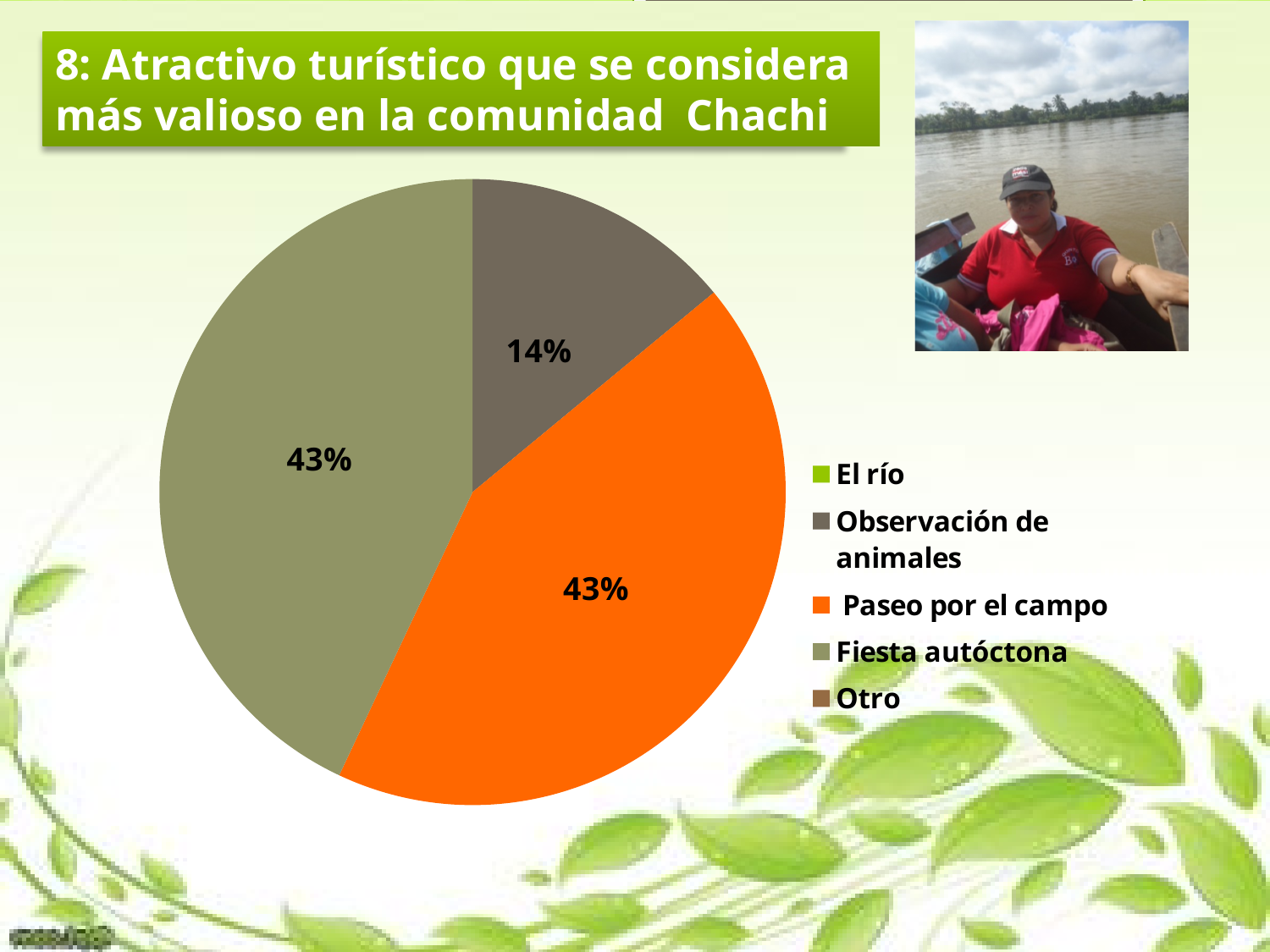
What share of the pie does Fiesta autóctona have? 43% Which category has the smallest visible slice of the pie? Observación de animales Which is larger, the slice for Paseo por el campo or the slice for Observación de animales? Paseo por el campo What share of the pie does Paseo por el campo have? 43% How many categories does the legend list? 5 What is the difference in percentage points between the Fiesta autóctona slice and the Observación de animales slice? 29 percentage points What is the title of the slide containing the chart? 8: Atractivo turístico que se considera más valioso en la comunidad Chachi What colour is the slice for Paseo por el campo? Orange What share of the pie does Observación de animales have? 14% How many slices with a printed percentage are visible in the pie? 3 What kind of chart is shown on the slide? Pie chart